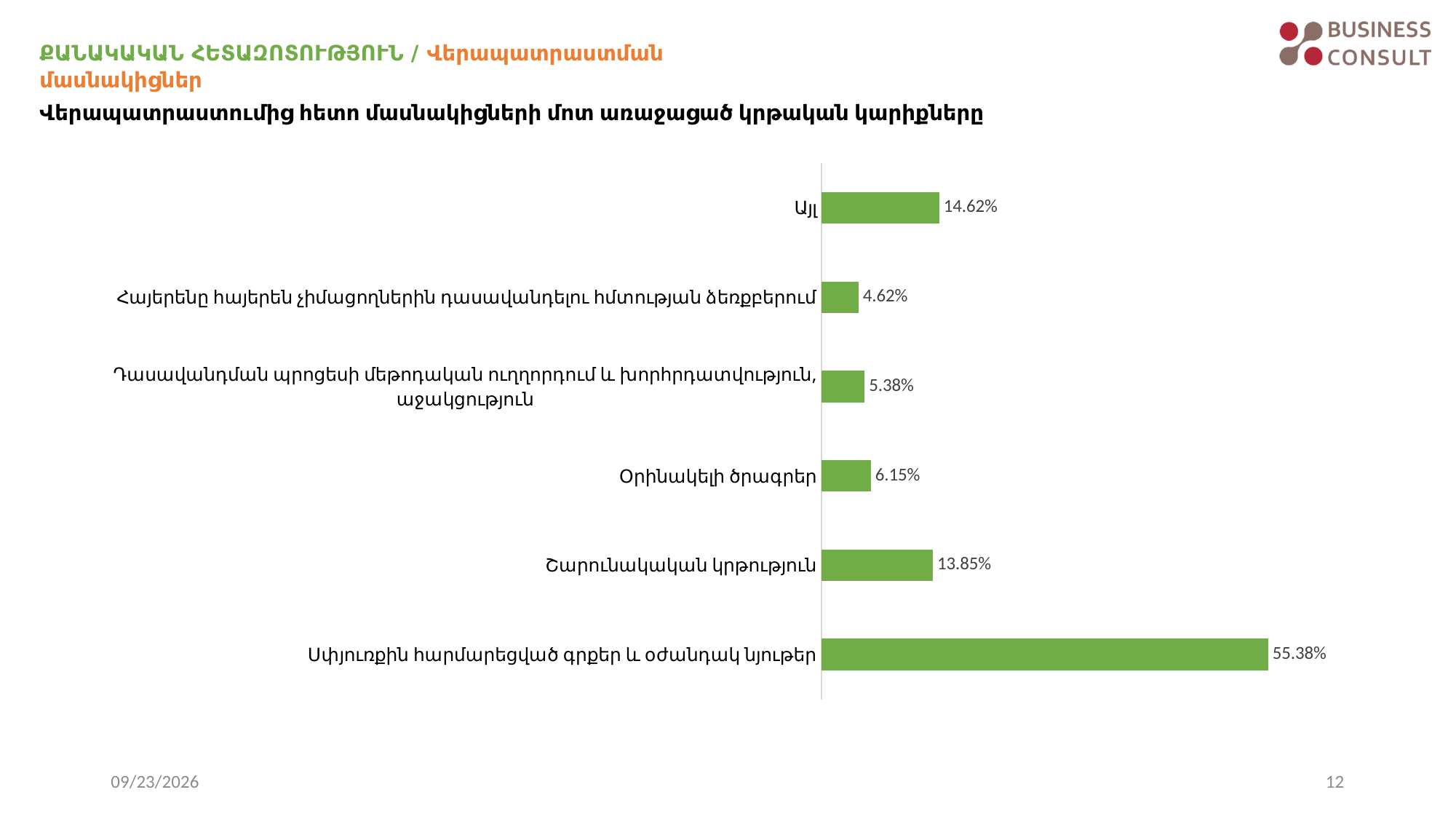
What colour are the bars in the chart? Green How many categories are shown in the chart? 6 Which category has the lowest value? Հայերենը հայերեն չիմացողներին դասավանդելու հմտության ձեռքբերում What is the difference between the values for "Սփյուռքին հարմարեցված գրքեր և օժանդակ նյութեր" and "Այլ"? 40.76% What value is shown for "Այլ"? 14.62% What value is shown for "Շարունակական կրթություն"? 13.85% Which category has the highest value? Սփյուռքին հարմարեցված գրքեր և օժանդակ նյութեր Which is larger, the value for "Օրինակելի ծրագրեր" or the value for "Դասավանդման պրոցեսի մեթոդական ուղղորդում և խորհրդատվություն, աջակցություն"? Օրինակելի ծրագրեր What is the difference between the values for "Այլ" and "Շարունակական կրթություն"? 0.77% What kind of chart is shown on the slide? Bar chart What value is shown for "Օրինակելի ծրագրեր"? 6.15% What value is shown for "Սփյուռքին հարմարեցված գրքեր և օժանդակ նյութեր"? 55.38%